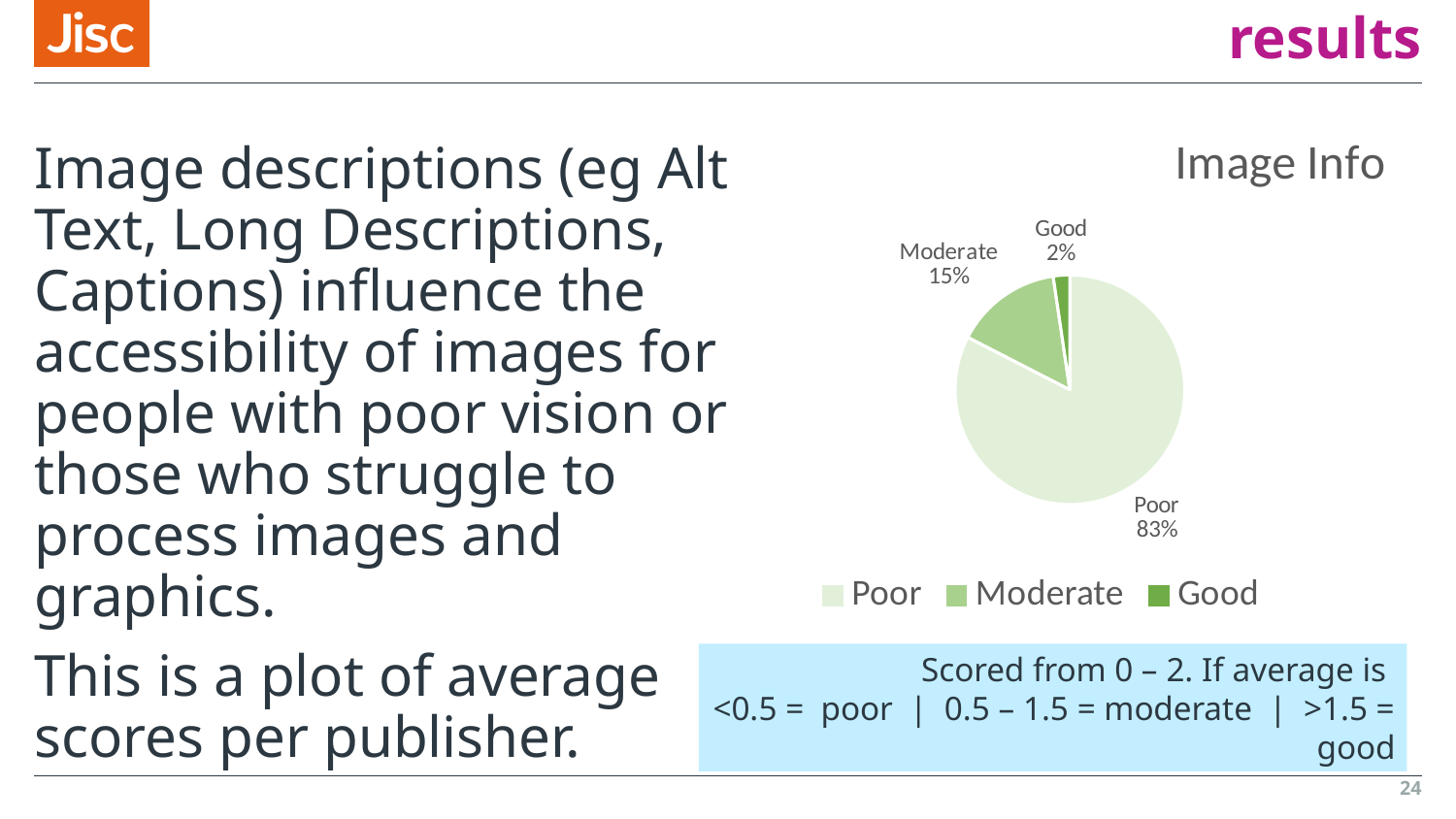
What percentage of the pie is labelled Moderate? 15% What type of chart is shown on the slide? pie chart What is the difference in percentage points between the Moderate and Good slices? 13 What percentage of the pie is labelled Good? 2% What percentage of the pie is labelled Poor? 83% How many entries does the legend list? 3 Which category has the largest share of the pie? Poor Which category has the smallest share of the pie? Good Which slice is larger, Moderate or Good? Moderate What is the difference in percentage points between the Poor and Moderate slices? 68 What is the title of the chart? Image Info How many categories does the pie chart show? 3